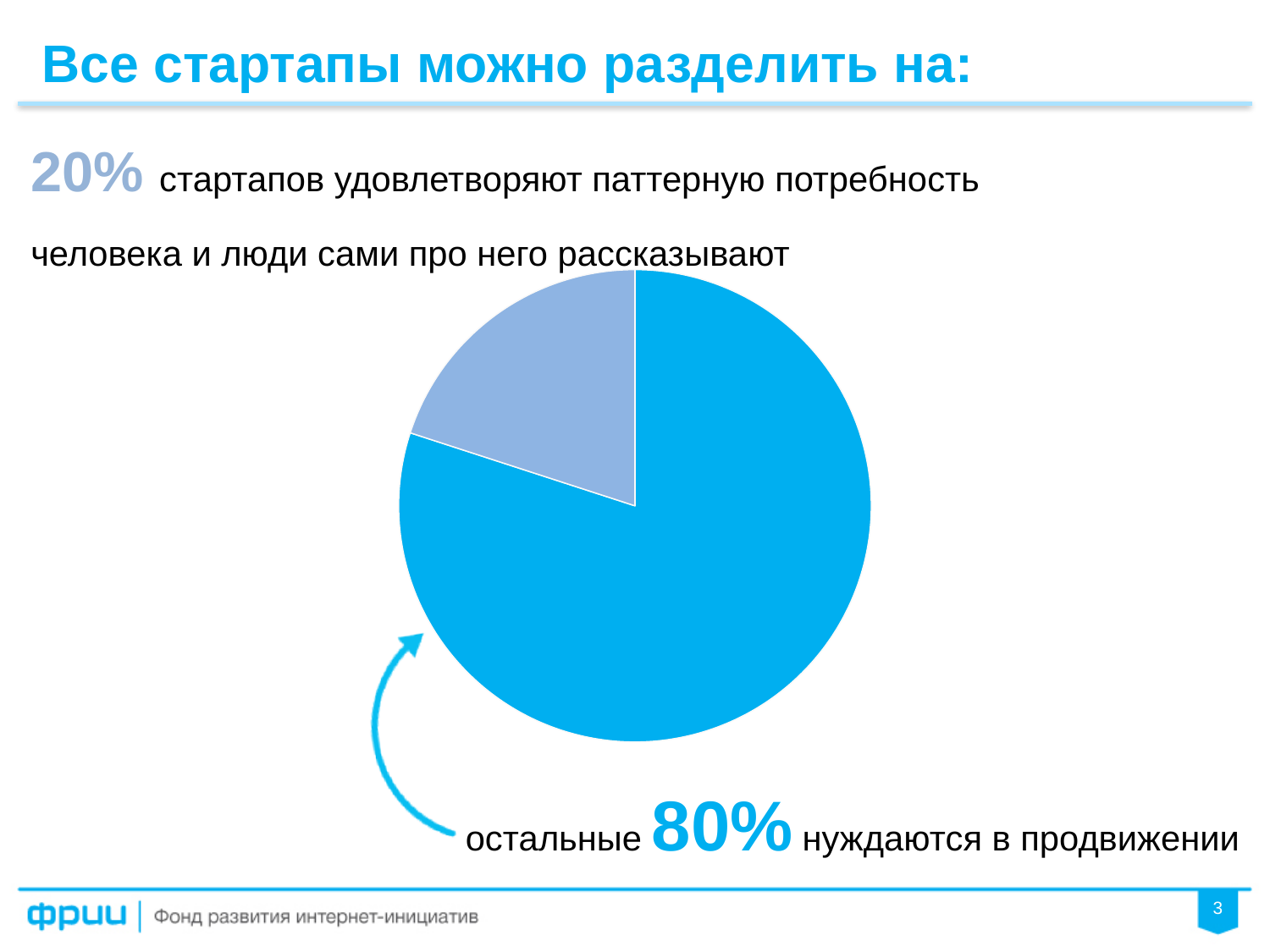
Which is larger: the share of startups that need promotion or the share that satisfy a pattern need? the share that need promotion (80%) What share of startups satisfy a pattern need and are talked about by people themselves (удовлетворяют паттерную потребность)? 20% What is the title of the slide containing the pie chart? Все стартапы можно разделить на: How many slices does the pie chart have? 2 What do the two slices of the pie chart add up to? 100% What share of startups need promotion (нуждаются в продвижении) according to the pie chart? 80% What kind of chart is shown on the slide? pie chart What is the difference in percentage points between the two slices of the pie chart? 60 Which slice of the pie chart is the smallest? 20% стартапов удовлетворяют паттерную потребность Which slice of the pie chart is the largest? остальные 80% нуждаются в продвижении What colour is the slice representing the 80% of startups that need promotion? bright blue